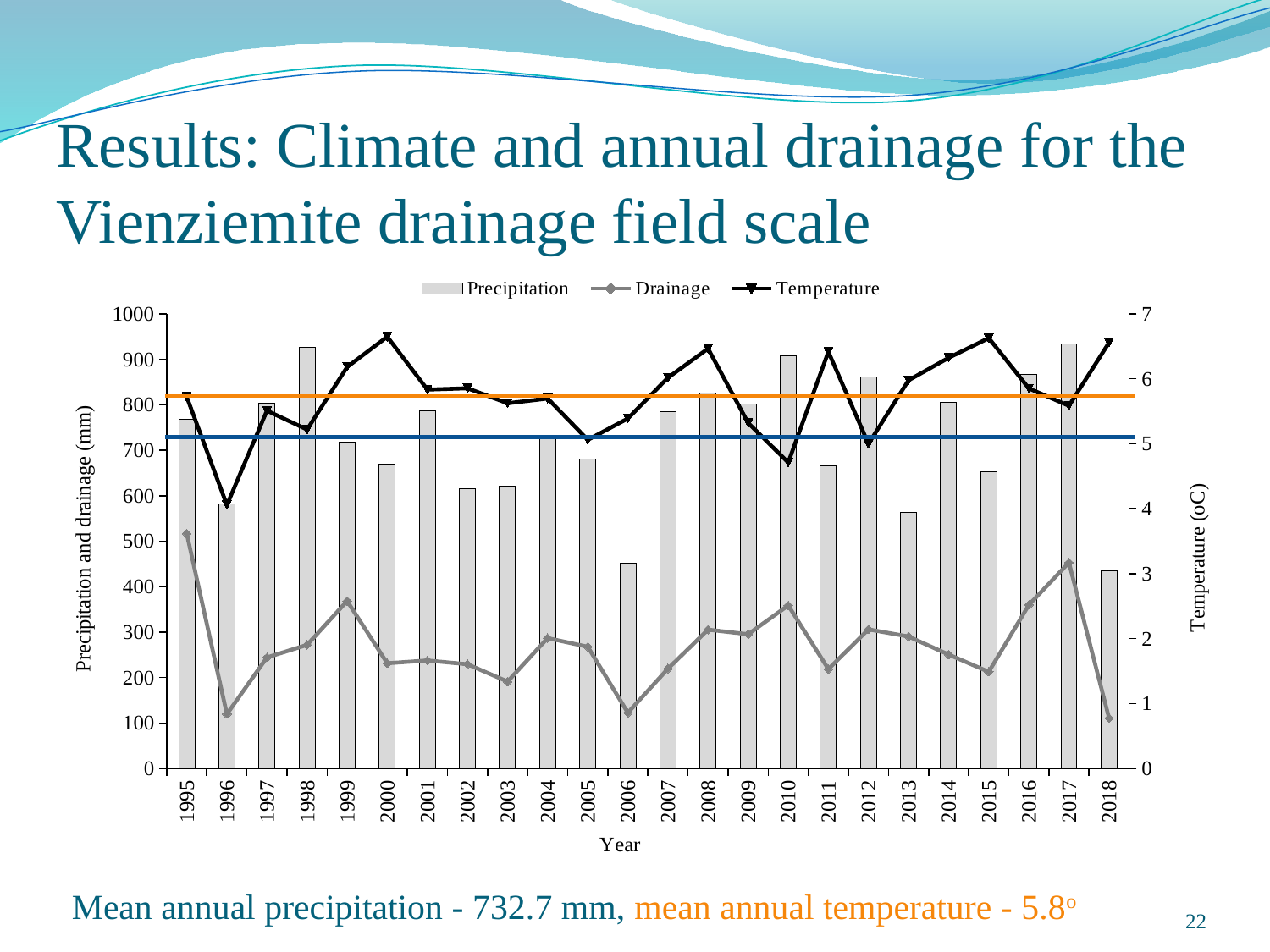
What is the title of the x axis of the chart? Year Is the precipitation value for 1998 greater or less than 900? greater Is the temperature value for 1996 greater or less than 5? less Is the drainage value for 2006 greater or less than 200? less How many years are shown on the x axis of the chart? 24 Which year has higher precipitation, 1998 or 2006? 1998 How many series does the chart legend list? 3 Which year has the lowest temperature? 1996 What kind of chart is shown on the slide? Combined bar and line chart Which year has the highest drainage? 1995